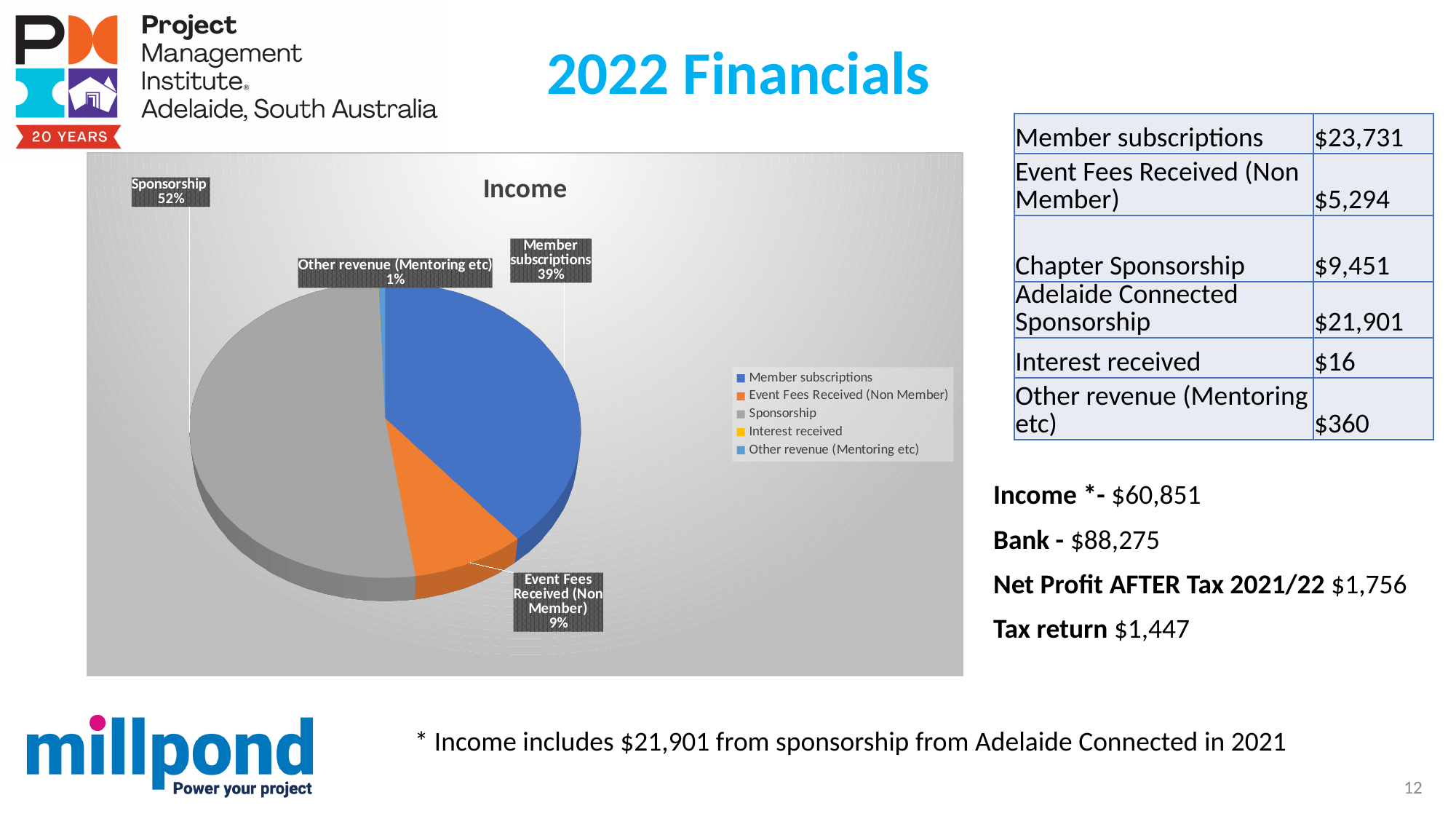
What is the combined share of the Sponsorship and Member subscriptions slices? 91% What share of the pie is Event Fees Received (Non Member)? 9% What is the difference in percentage points between the Sponsorship slice and the Member subscriptions slice? 13 What share of the pie is Other revenue (Mentoring etc)? 1% What share of the pie is Member subscriptions? 39% What kind of chart is shown on the slide? pie chart What colour is the Sponsorship slice in the pie chart? grey How many entries does the chart's legend list? 5 What is the title of the chart? Income Which is larger, the slice for Member subscriptions or the slice for Event Fees Received (Non Member)? Member subscriptions Which category has the largest slice of the pie? Sponsorship